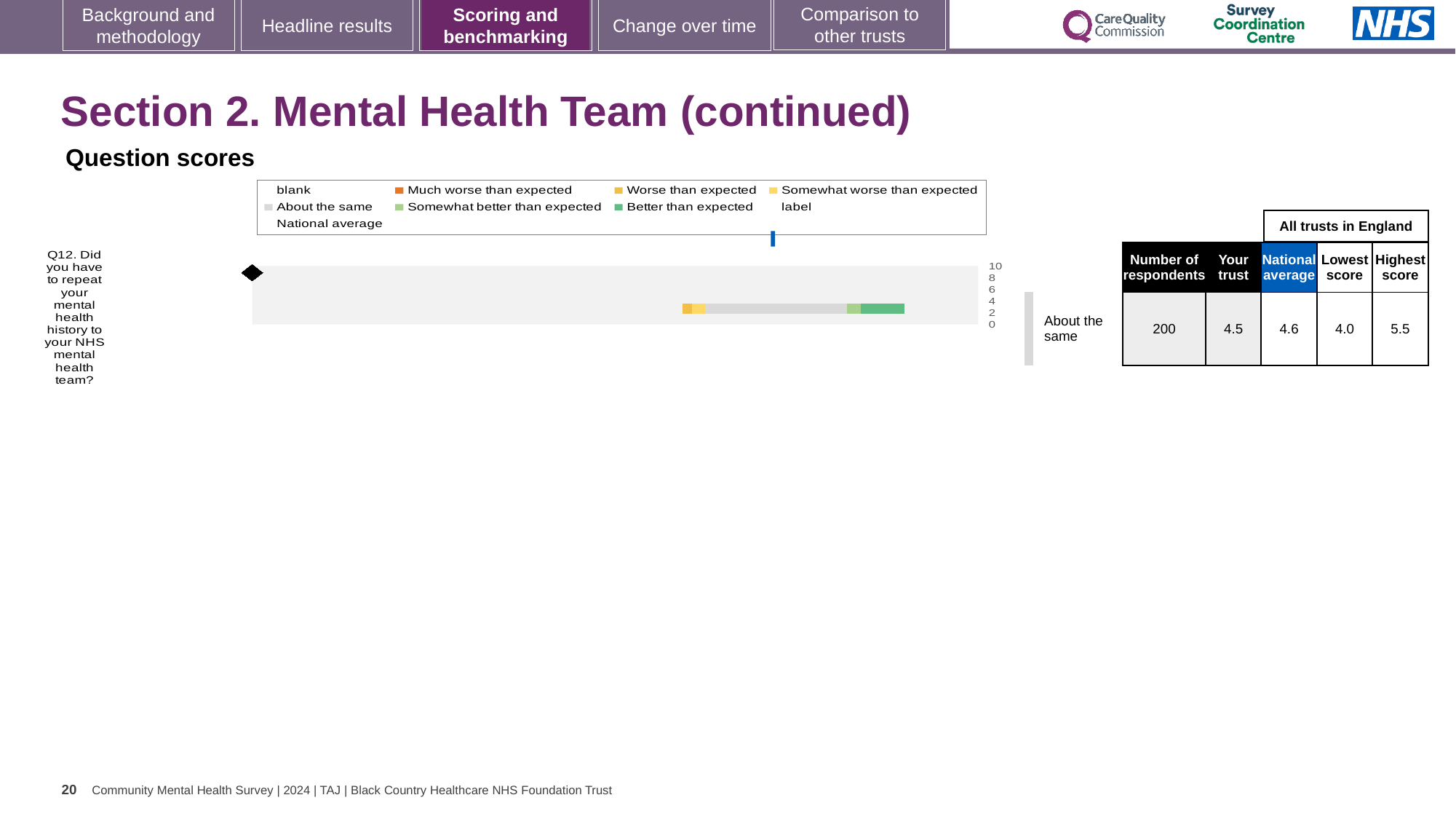
What is the lowest score among all trusts in England for Q12? 4.0 How many respondents answered Q12? 200 How many survey questions are plotted on the chart? 1 What is the national average score for Q12? 4.6 What kind of chart is used to show the Q12 question score? bar chart What is the 'Your trust' score for Q12 (repeating mental health history)? 4.5 How many entries does the chart legend list? 9 What benchmark category is shown next to the Q12 bar? About the same What is the difference between the highest score and the lowest score for Q12? 1.5 What is the highest score among all trusts in England for Q12? 5.5 Which is larger for Q12: the 'Your trust' score or the national average? National average What is the difference between the national average and the 'Your trust' score for Q12? 0.1